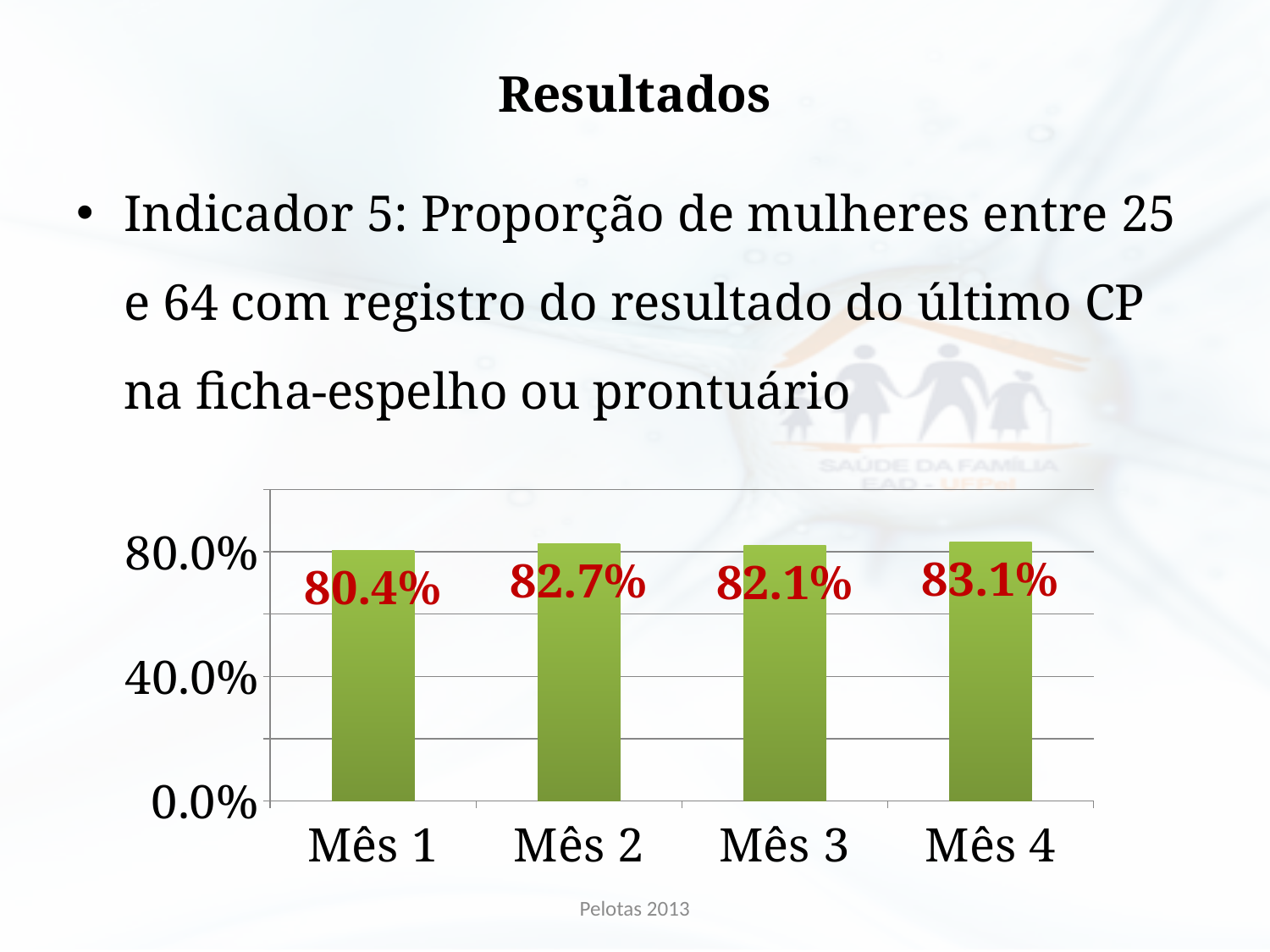
Which is larger, the value for Mês 2 or the value for Mês 3? Mês 2 What colour are the bars in the chart? green What is the value for Mês 4? 83.1% Is the value for Mês 1 greater or less than 40.0%? greater How many months are shown on the x axis? 4 What is the value for Mês 1? 80.4% What is the difference between the values for Mês 4 and Mês 1? 2.7 percentage points What is the value for Mês 3? 82.1% Which month has the lowest value? Mês 1 What kind of chart is shown on the slide? bar chart What is the value for Mês 2? 82.7% Which month has the highest value? Mês 4